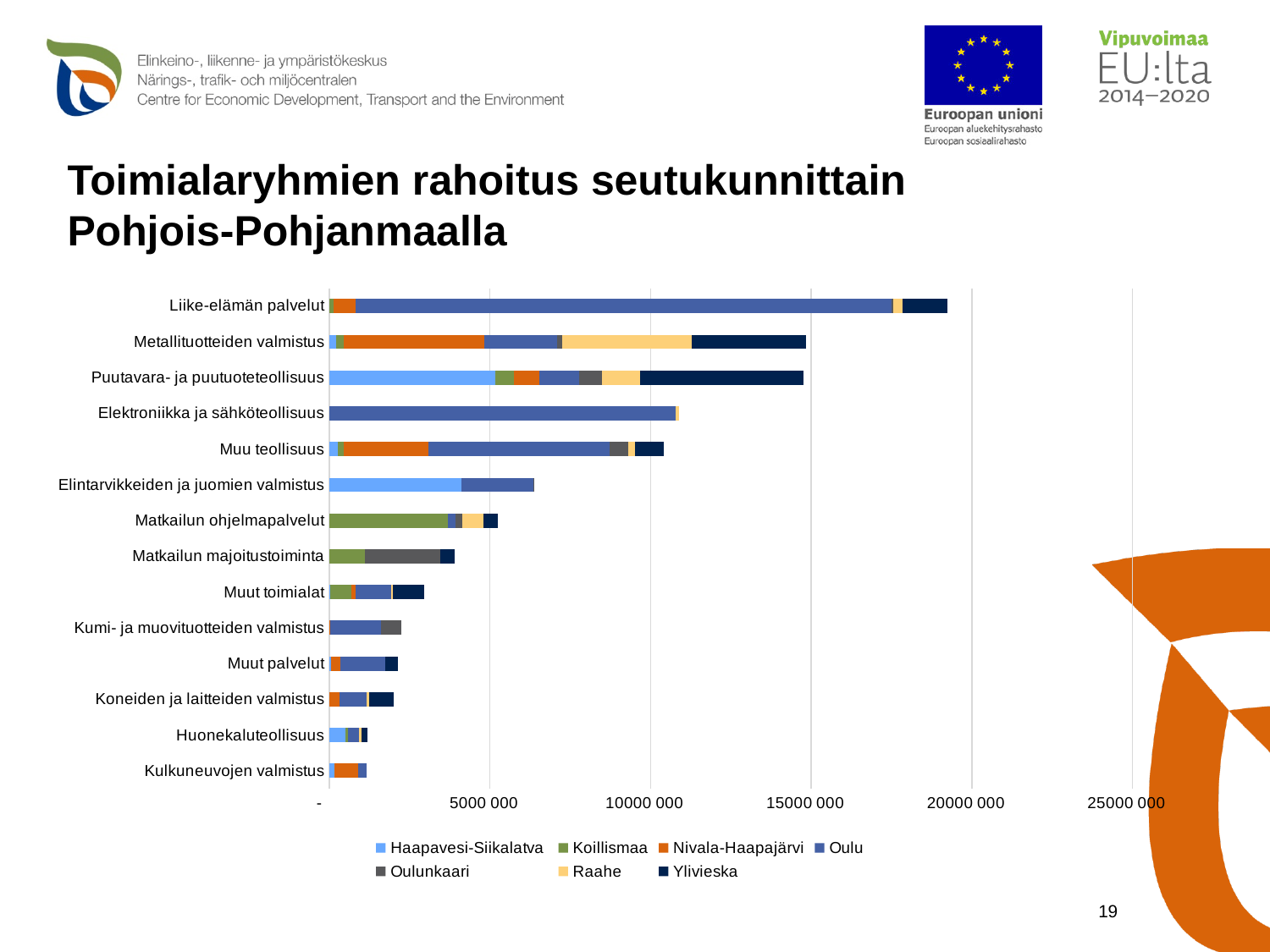
Is the total value for Elektroniikka ja sähköteollisuus greater or less than 10000 000? greater What is the title of the slide containing the chart? Toimialaryhmien rahoitus seutukunnittain Pohjois-Pohjanmaalla How many series does the chart legend list? 7 Is the total value for Elintarvikkeiden ja juomien valmistus greater or less than 5000 000? greater What kind of chart is shown on the slide? Stacked bar chart Which has the larger total bar, Muu teollisuus or Elintarvikkeiden ja juomien valmistus? Muu teollisuus Which category has the longest total bar? Liike-elämän palvelut How many industry categories are plotted on the chart? 14 Which has the larger total bar, Matkailun majoitustoiminta or Muut toimialat? Matkailun majoitustoiminta Which series in the legend is shown in orange? Nivala-Haapajärvi Is the total value for Liike-elämän palvelut greater or less than 15000 000? greater